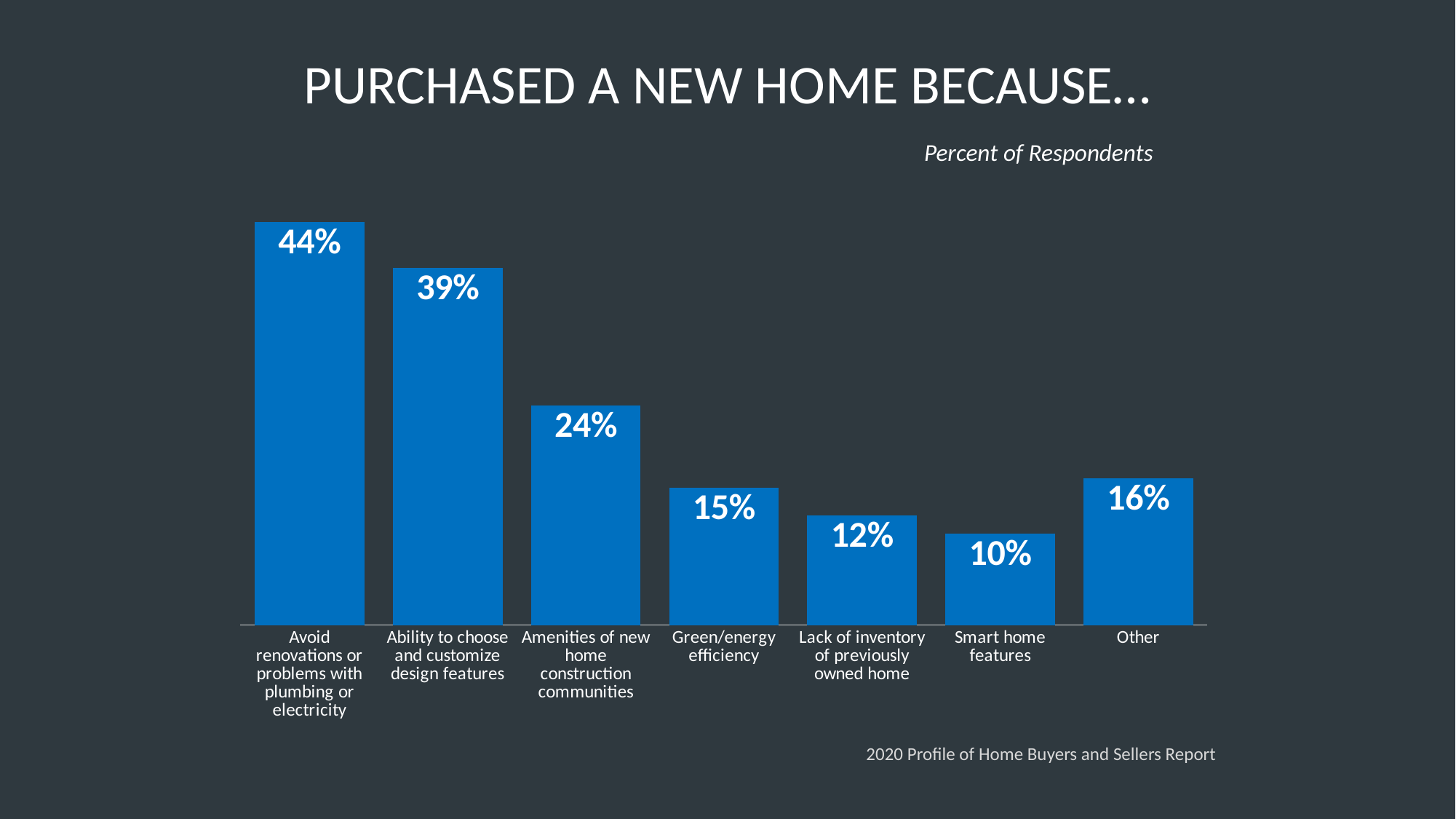
What percent of respondents cited amenities of new home construction communities? 24% What is the value for 'Smart home features'? 10% What is the title of the chart? PURCHASED A NEW HOME BECAUSE… What is the value for 'Ability to choose and customize design features'? 39% What is the difference between 'Other' and 'Green/energy efficiency'? 1% What kind of chart is shown on the slide? Bar chart Which reason has the highest percent of respondents? Avoid renovations or problems with plumbing or electricity Which reason has the lowest percent of respondents? Smart home features How many reasons (categories) are shown in the chart? 7 What percent of respondents purchased a new home to avoid renovations or problems with plumbing or electricity? 44% Which is larger: 'Lack of inventory of previously owned home' or 'Other'? Other What is the difference between 'Avoid renovations or problems with plumbing or electricity' and 'Ability to choose and customize design features'? 5%